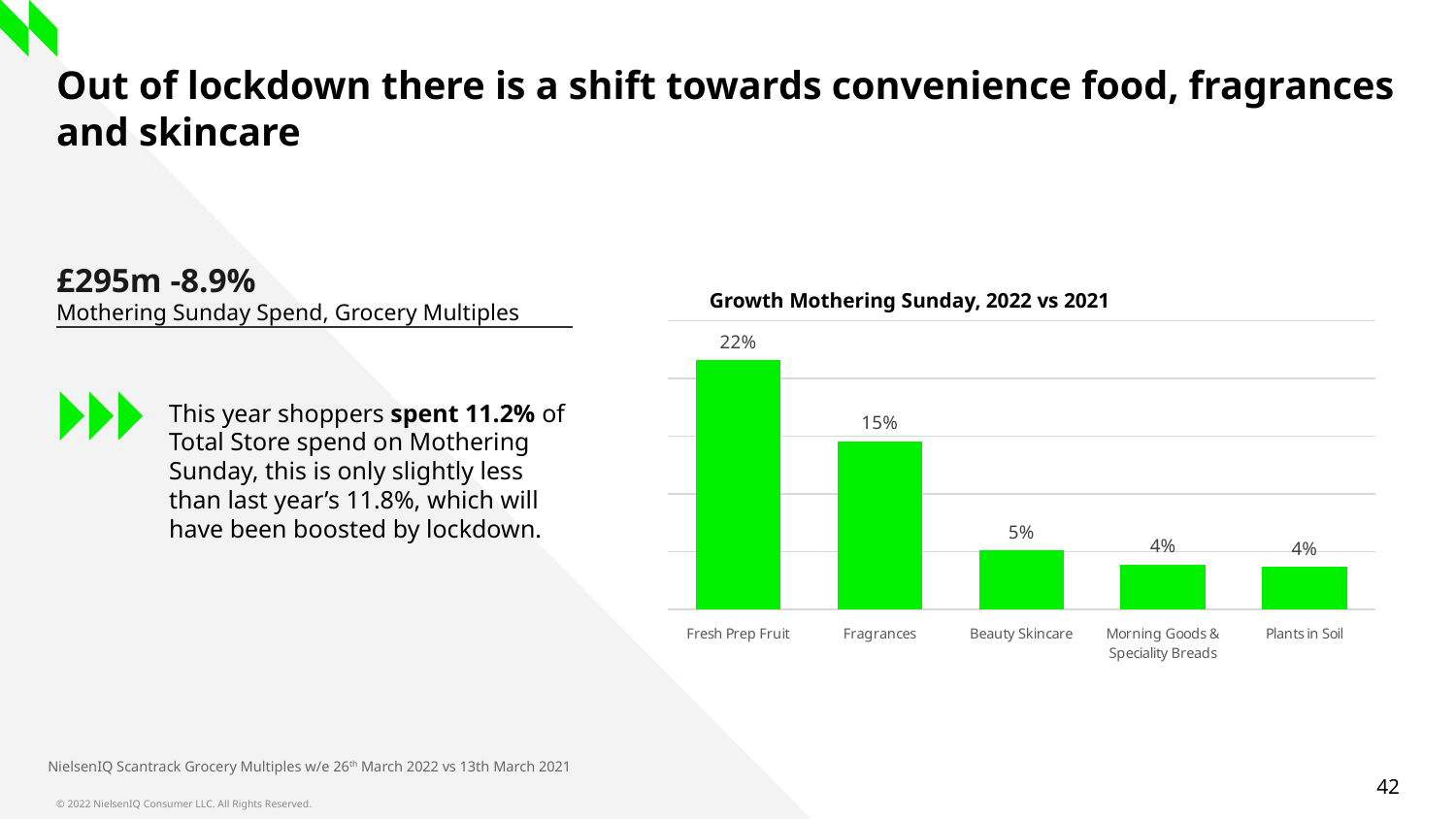
How many categories are shown in the chart? 5 What is the growth value for Beauty Skincare? 5% What is the difference in growth between Fresh Prep Fruit and Fragrances? 7% Which has higher growth, Fragrances or Beauty Skincare? Fragrances What is the title of the chart? Growth Mothering Sunday, 2022 vs 2021 What is the difference in growth between Fragrances and Beauty Skincare? 10% What is the growth value for Morning Goods & Speciality Breads? 4% What kind of chart is shown on the slide? Bar chart Which category has the highest growth? Fresh Prep Fruit What is the growth value for Fragrances? 15% What is the growth value for Fresh Prep Fruit? 22% Do the values rise or fall from left to right across the categories? Fall